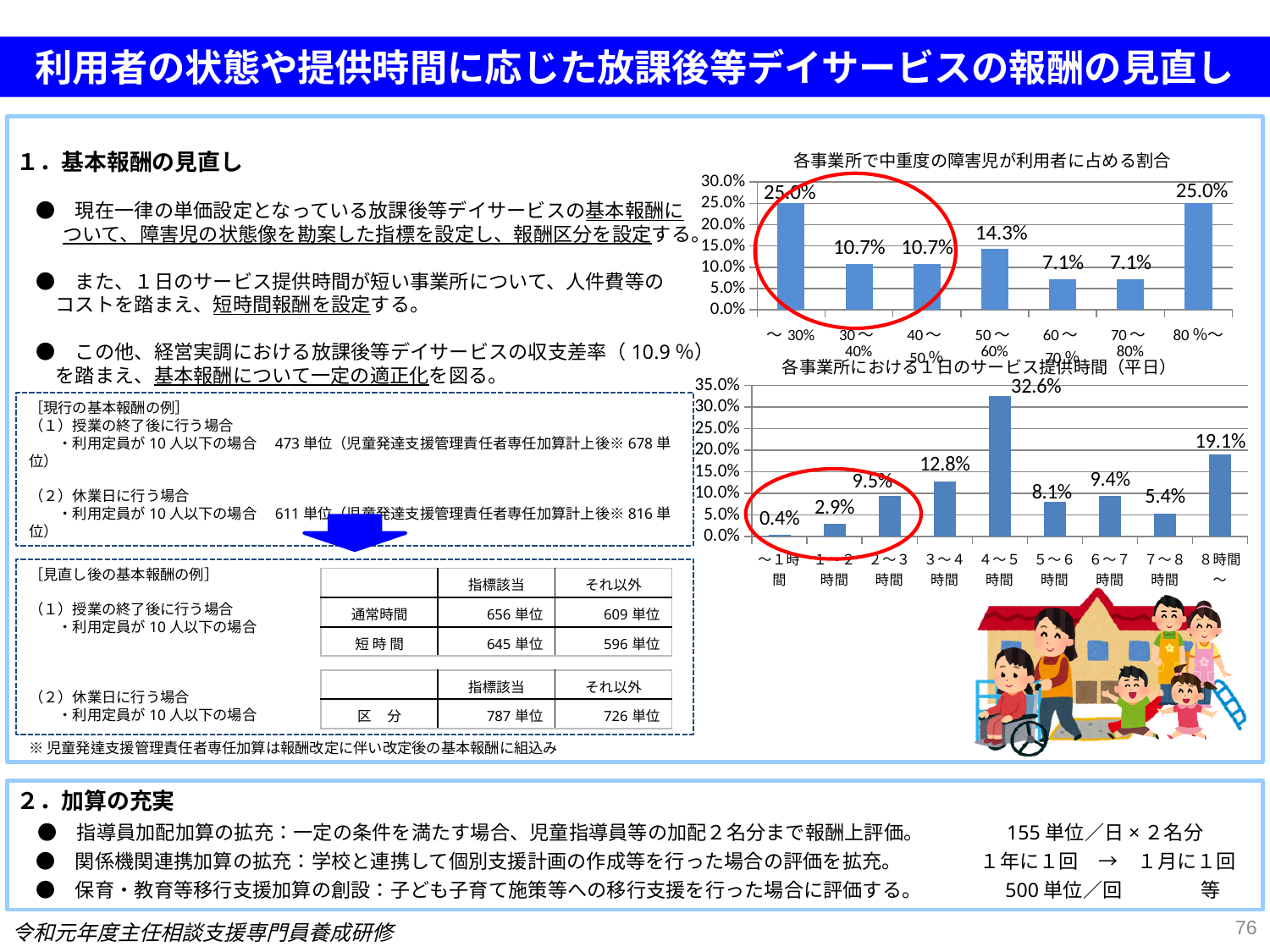
In the bottom chart titled 各事業所における1日のサービス提供時間（平日）, which category has the lowest value? ～1時間 In the top chart titled 各事業所で中重度の障害児が利用者に占める割合, what is the value for the 50～60% category? 14.3% In the bottom chart titled 各事業所における1日のサービス提供時間（平日）, what is the value for 3～4時間? 12.8% In the top chart titled 各事業所で中重度の障害児が利用者に占める割合, what is the difference between the values for ～30% and 30～40%? 14.3% In the bottom chart titled 各事業所における1日のサービス提供時間（平日）, what is the difference between the values for 4～5時間 and 5～6時間? 24.5% In the top chart titled 各事業所で中重度の障害児が利用者に占める割合, which is larger, the value for 50～60% or the value for 60～70%? 50～60% In the bottom chart titled 各事業所における1日のサービス提供時間（平日）, what is the value for 8時間～? 19.1% In the bottom chart titled 各事業所における1日のサービス提供時間（平日）, which category has the highest value? 4～5時間 In the bottom chart titled 各事業所における1日のサービス提供時間（平日）, how many categories are shown on the x axis? 9 In the top chart titled 各事業所で中重度の障害児が利用者に占める割合, how many categories are shown on the x axis? 7 What type of chart is the bottom chart titled 各事業所における1日のサービス提供時間（平日）? Bar chart In the top chart titled 各事業所で中重度の障害児が利用者に占める割合, what is the value for the 80%～ category? 25.0%